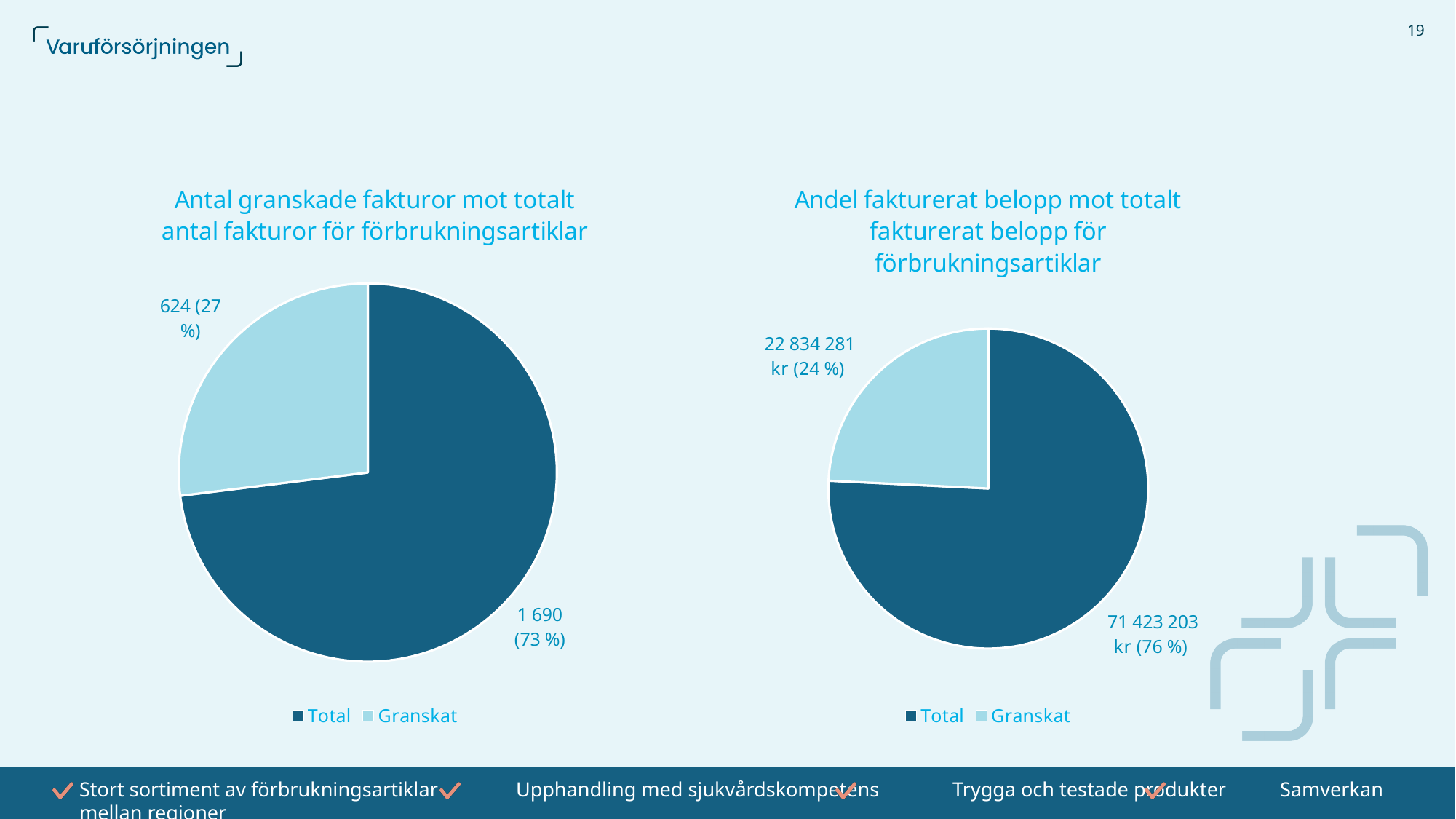
In the right pie chart (Andel fakturerat belopp...), which slice is larger, Total or Granskat? Total In the left pie chart (Antal granskade fakturor...), what is the difference between the Total value and the Granskat value? 1 066 How many entries does the legend of the left pie chart (Antal granskade fakturor...) list? 2 What type of chart is used on the left of the slide, titled 'Antal granskade fakturor mot totalt antal fakturor för förbrukningsartiklar'? Pie chart In the left pie chart (Antal granskade fakturor...), what is the value shown for Total? 1 690 In the left pie chart (Antal granskade fakturor...), what share of the pie does Total represent? 73 % In the right pie chart (Andel fakturerat belopp...), what is the value shown for Granskat? 22 834 281 kr How many slices does the right pie chart (Andel fakturerat belopp...) have? 2 In the left pie chart (Antal granskade fakturor...), what share of the pie does Granskat represent? 27 % In the right pie chart (Andel fakturerat belopp...), what is the value shown for Total? 71 423 203 kr In the right pie chart (Andel fakturerat belopp...), what share of the pie does Granskat represent? 24 % In the left pie chart (Antal granskade fakturor...), what is the value shown for Granskat? 624